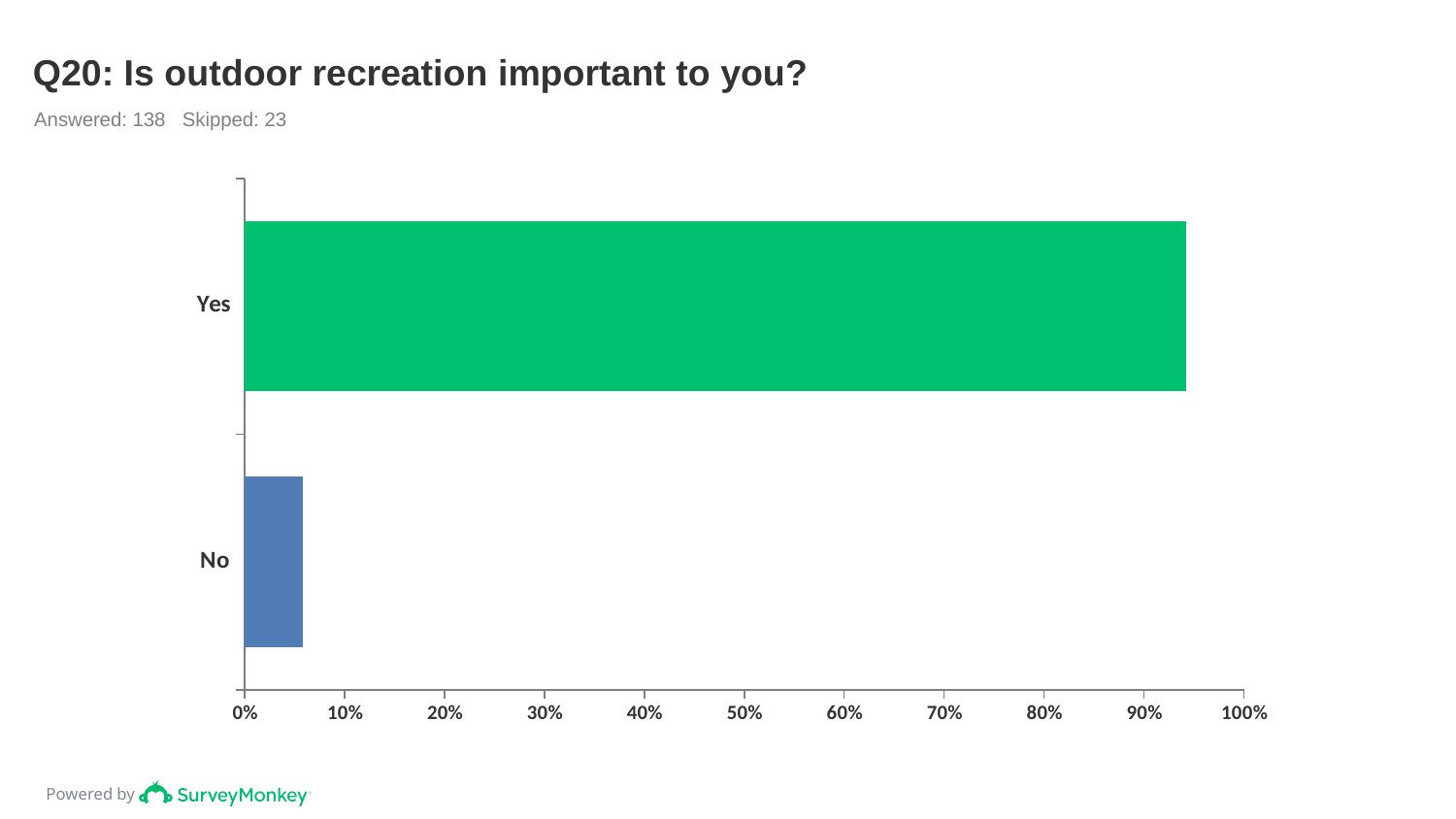
What kind of chart is shown on the slide? bar chart Which category has the highest value? Yes What colour is the bar for Yes? green Is the value for Yes greater or less than 50%? greater Is the value for No greater or less than 10%? less Is the value for Yes greater or less than 90%? greater What is the maximum value shown on the x axis? 100% How many categories are plotted in the chart? 2 Which is larger, the value for Yes or the value for No? Yes What is the title of the chart? Q20: Is outdoor recreation important to you? Which category has the lowest value? No